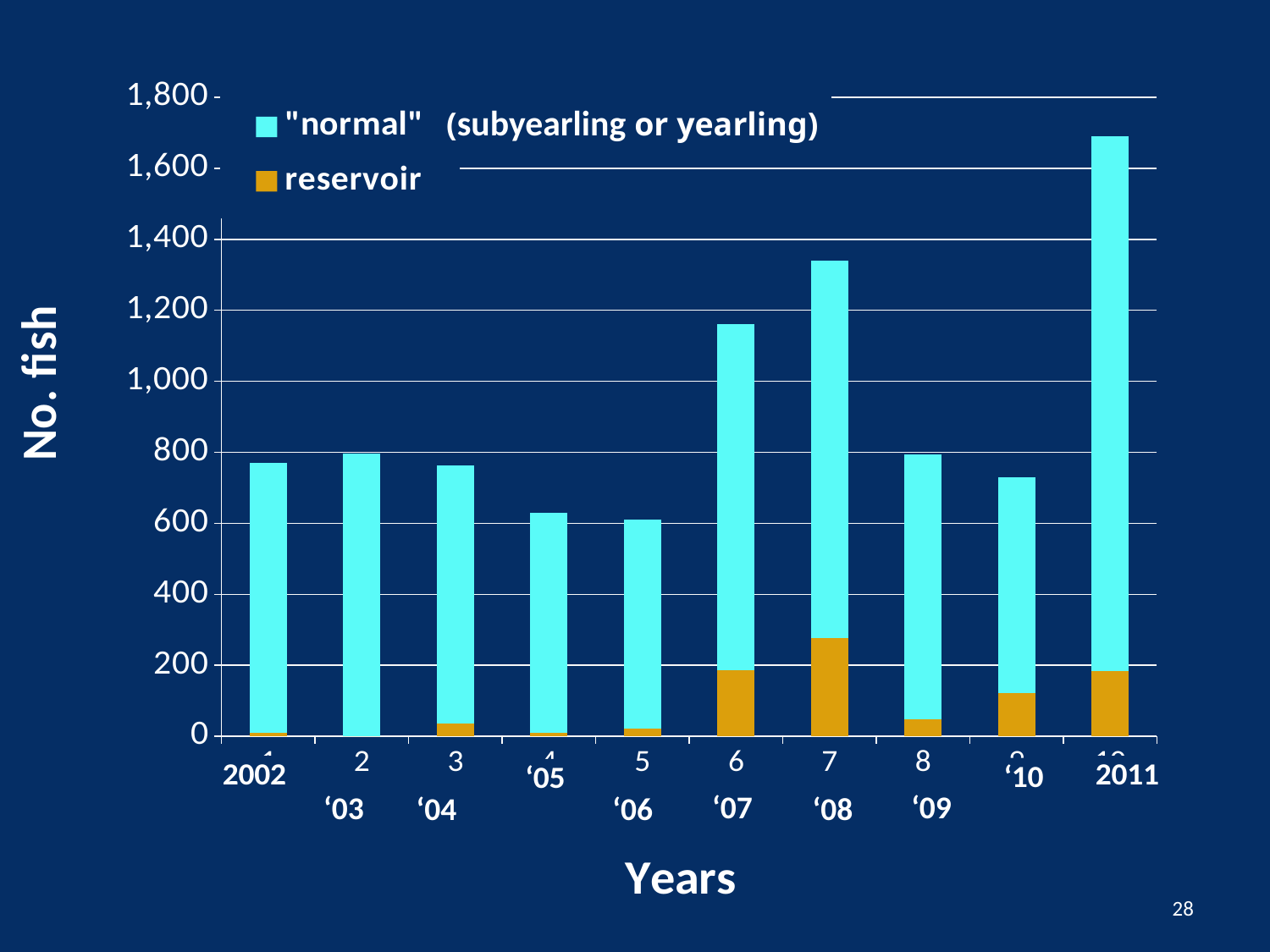
Is the total value for 2008 greater or less than 1,200? greater How many series does the legend list? 2 Is the reservoir value for 2008 greater or less than 200? greater Which year has the largest reservoir segment? 2008 Which year has the larger total, 2007 or 2008? 2008 Is the total value for 2011 greater or less than 1,600? greater Which year has the larger total, 2003 or 2010? 2003 Which year has the highest total number of fish? 2011 What is the label on the vertical axis? No. fish How many years (bars) are plotted on the chart? 10 What kind of chart is shown on the slide? stacked bar chart